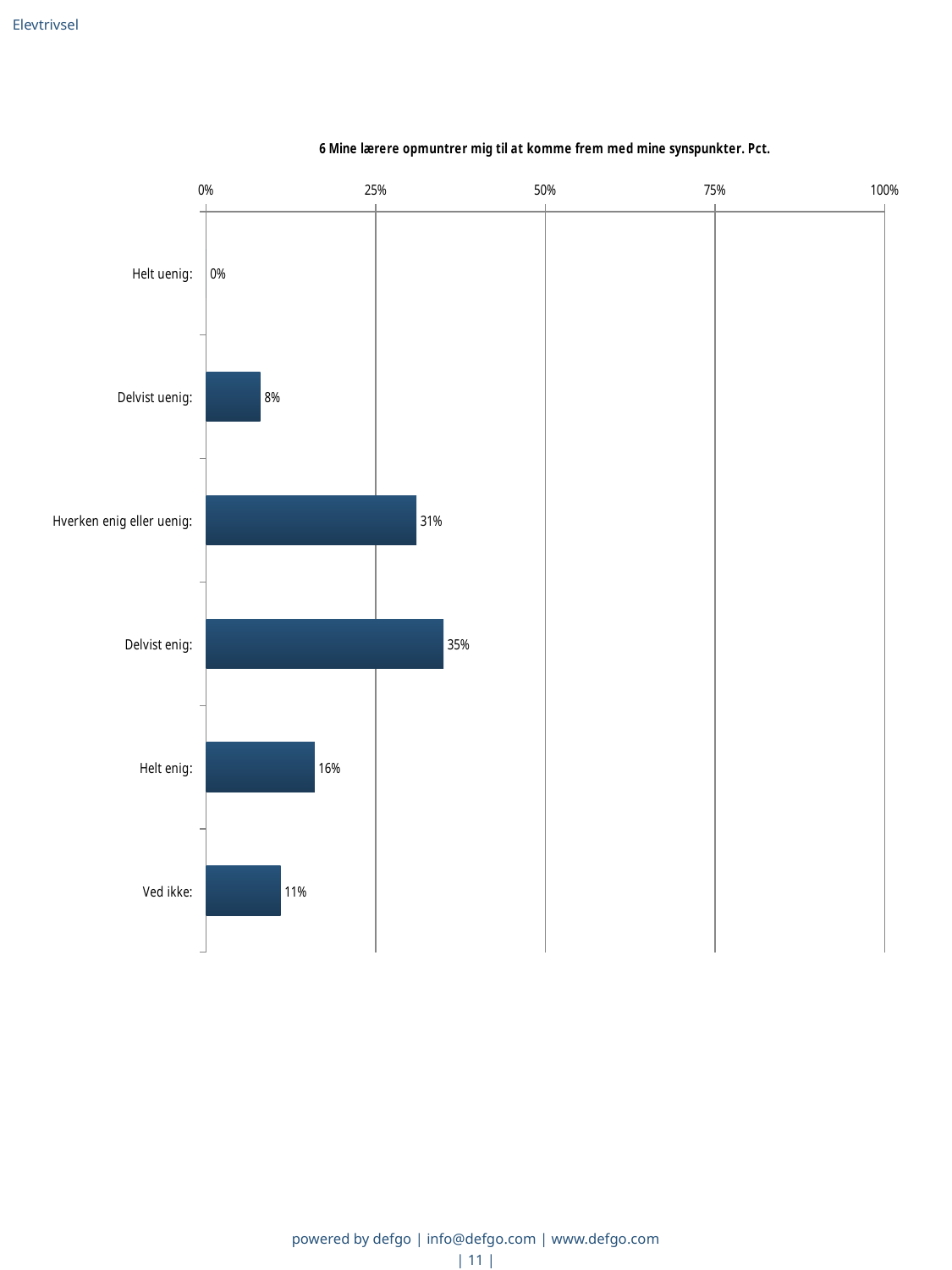
What is the value for Helt uenig? 0% What is the value for Ved ikke? 11% What is the value for Delvist enig? 35% What is the value for Hverken enig eller uenig? 31% What kind of chart is shown? Bar chart What is the title of the chart? 6 Mine lærere opmuntrer mig til at komme frem med mine synspunkter. Pct. Which category has the highest value? Delvist enig Which category has the lowest value? Helt uenig What is the difference between the values for Delvist enig and Helt enig? 19% How many categories are shown on the chart? 6 Is the value for Hverken enig eller uenig greater or less than 25%? greater Which is larger, the value for Delvist uenig or the value for Ved ikke? Ved ikke